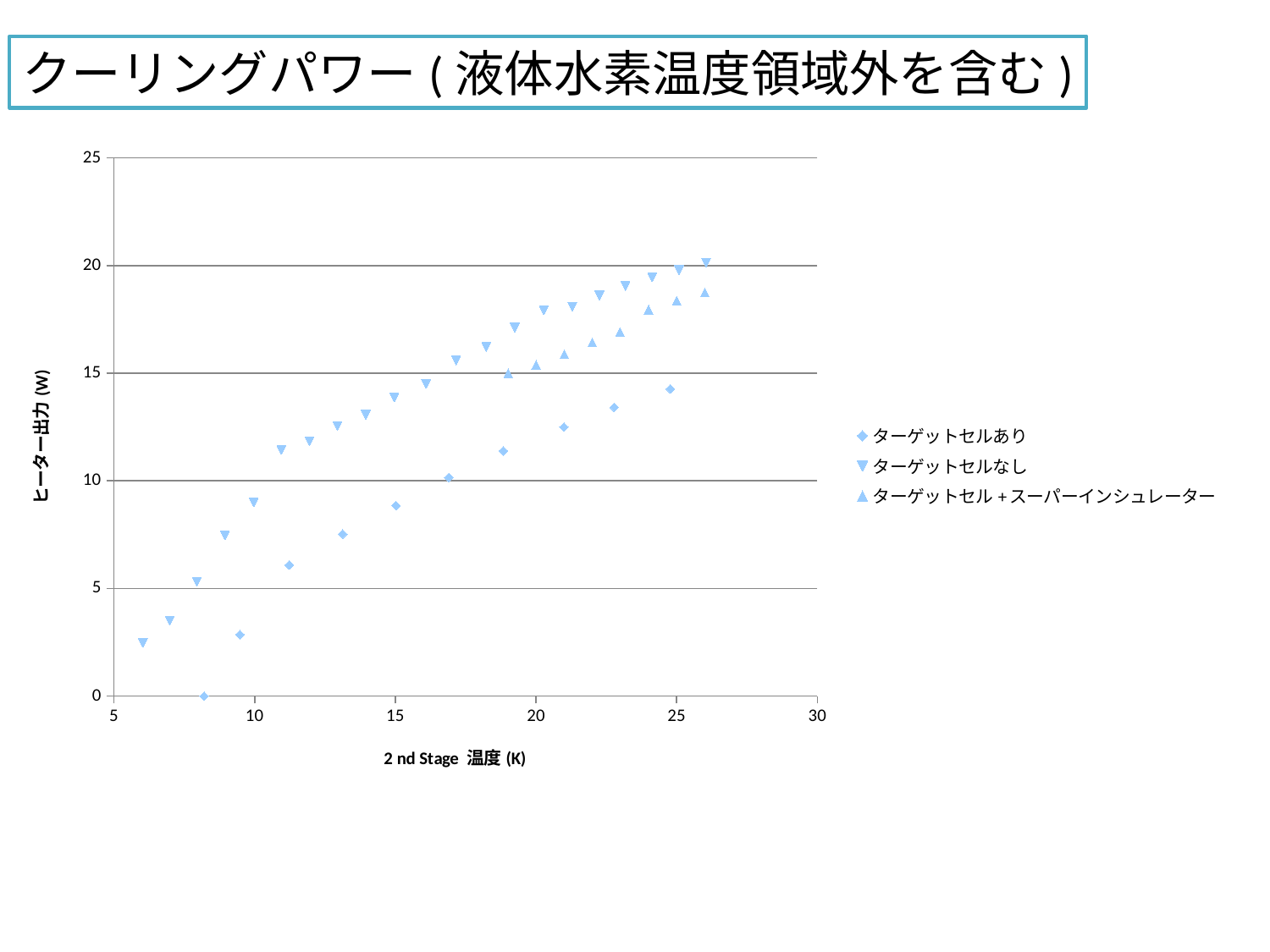
Is the value for ターゲットセルあり at 25 K greater or less than 15? less Do the values for ターゲットセルあり rise or fall as the 2nd stage temperature increases? rise What is the title of the x axis? 2 nd Stage 温度 (K) Do the values for ターゲットセルなし rise or fall as the 2nd stage temperature increases? rise What is the title of the y axis? ヒーター出力 (W) Which series has the lowest heater output values across the temperature range? ターゲットセルあり At 25 K, which series has the larger value: ターゲットセルなし or ターゲットセル＋スーパーインシュレーター? ターゲットセルなし What kind of chart is shown on the slide? scatter chart Is the value for ターゲットセルなし at 20 K greater or less than 15? greater How many series does the legend list? 3 Is the value for ターゲットセルあり at 15 K greater or less than 10? less